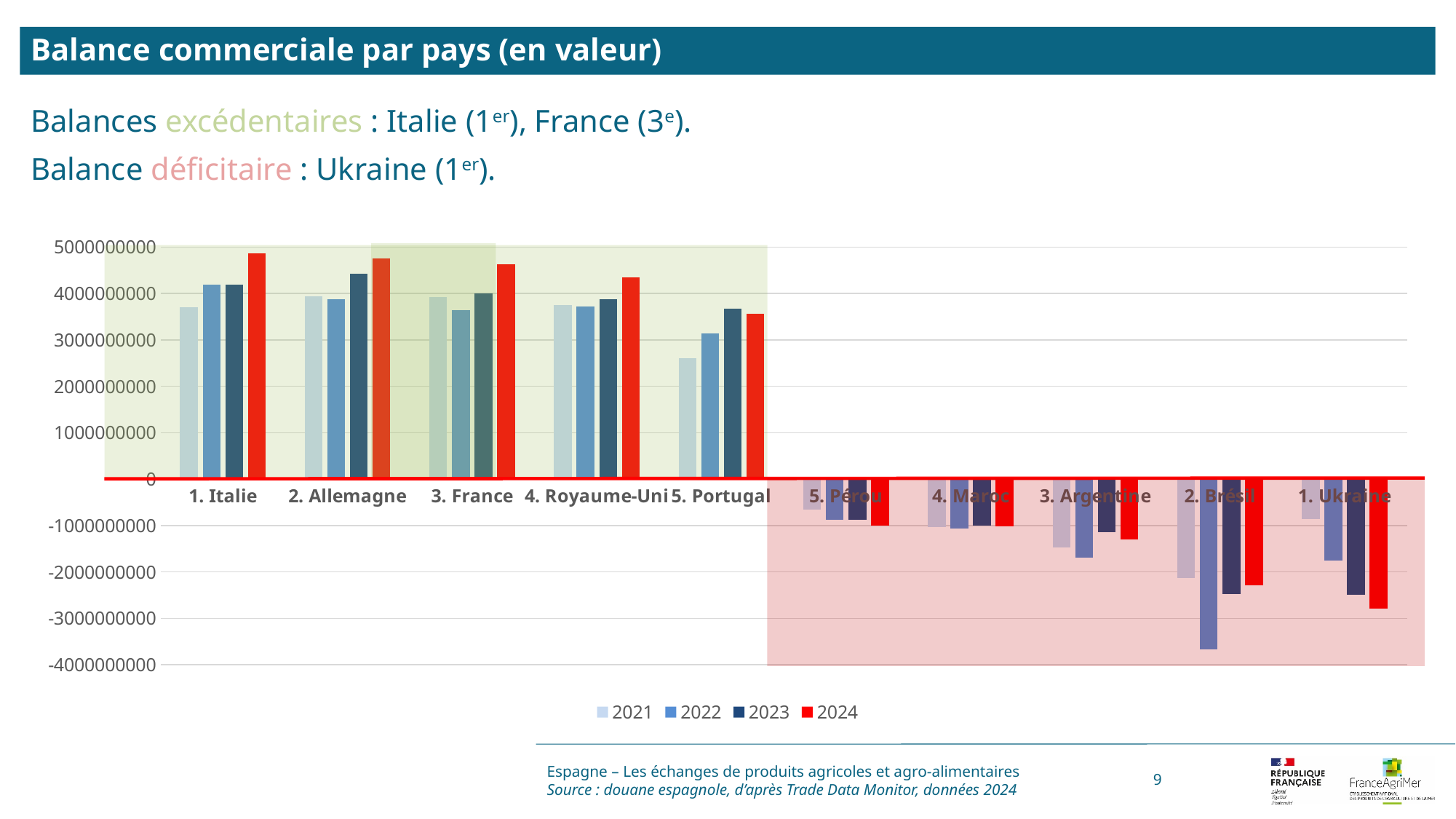
Is the 2024 value for 1. Italie greater or less than 4000000000? greater Which country has the lowest 2024 value in the chart? 1. Ukraine What kind of chart is shown on the slide? bar chart What colour represents the 2024 series in the legend? red Is the 2021 value for 5. Pérou greater or less than -1000000000? greater Is the 2021 value for 5. Portugal greater or less than 3000000000? less How many countries are shown on the x axis of the chart? 10 How many series does the legend list? 4 Do the values for 1. Ukraine rise or fall from 2021 to 2024? fall Which is larger, the 2024 value for 1. Italie or the 2024 value for 5. Portugal? 1. Italie